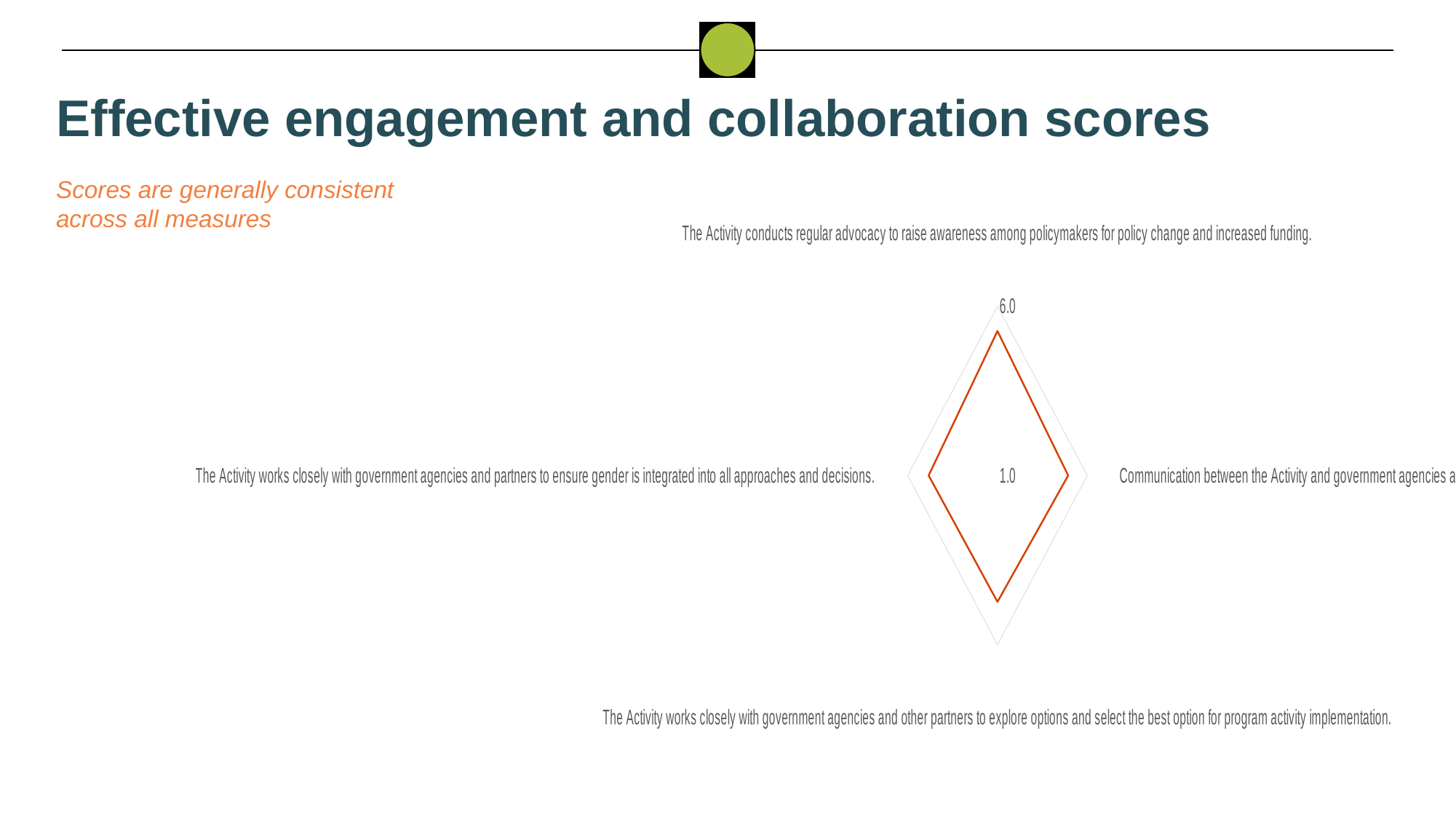
What is the highest axis tick value shown on the radar chart? 6.0 Is the value for "The Activity works closely with government agencies and other partners to explore options and select the best option for program activity implementation." greater or less than 6.0? less What is the lowest axis tick value shown on the radar chart? 1.0 What colour is the plotted data line on the radar chart? Orange Is the value for "The Activity conducts regular advocacy to raise awareness among policymakers for policy change and increased funding." greater or less than 6.0? less Is the value for "The Activity conducts regular advocacy to raise awareness among policymakers for policy change and increased funding." greater or less than 1.0? greater How many axes (categories) does the radar chart have? 4 What kind of chart is shown on the slide? Radar chart